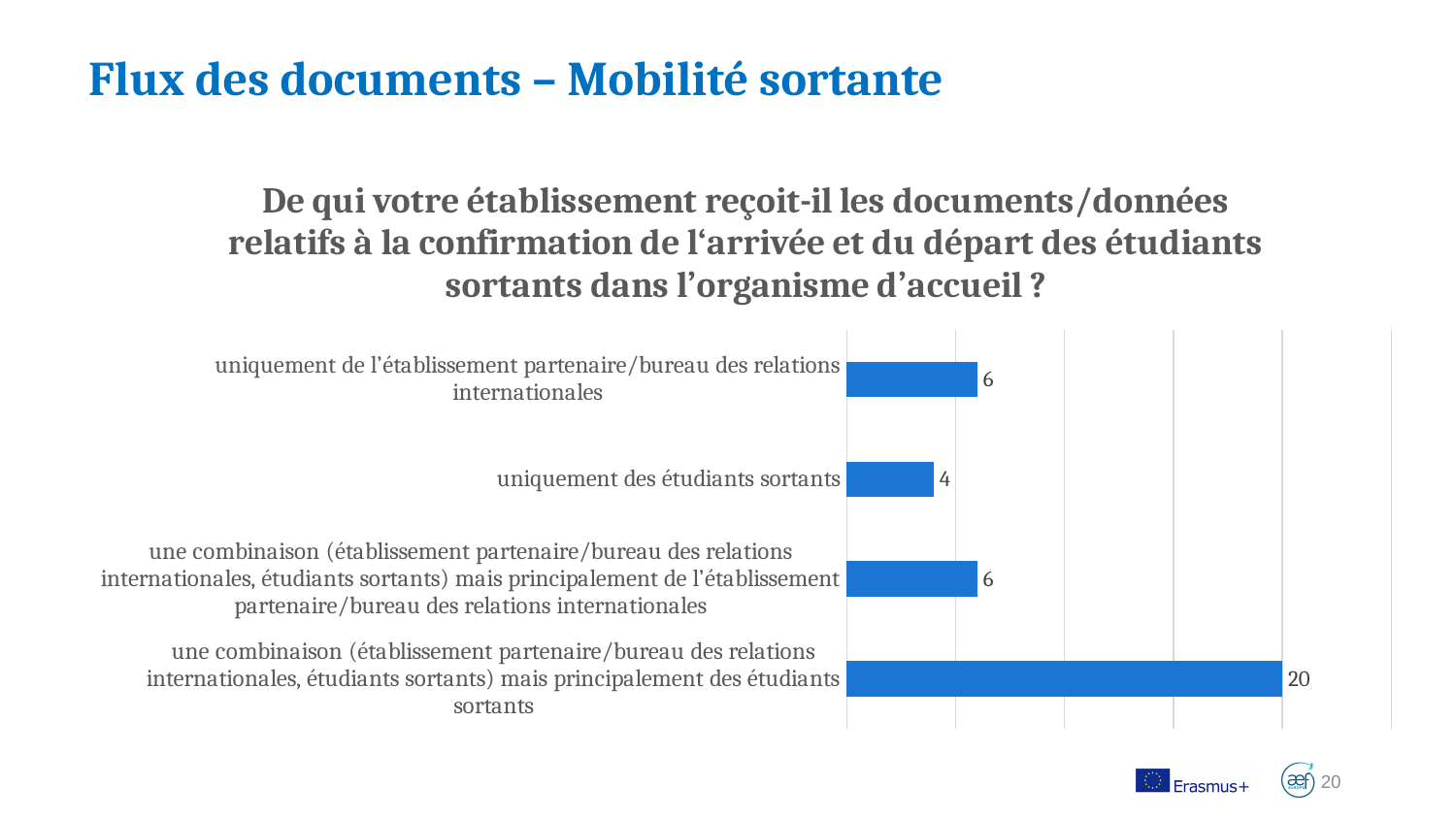
What type of chart is shown on the slide? bar chart What is the difference between the highest value (20) and the value for "uniquement des étudiants sortants"? 16 What is the value for the combination option that is mainly from outgoing students ("principalement des étudiants sortants")? 20 What is the value for "uniquement des étudiants sortants"? 4 Which category has the highest value? une combinaison (établissement partenaire/bureau des relations internationales, étudiants sortants) mais principalement des étudiants sortants What colour are the bars in the chart? blue Which category has the lowest value? uniquement des étudiants sortants What is the value for the combination option that is mainly from the partner institution/international relations office? 6 What is the difference between the value for "uniquement de l'établissement partenaire/bureau des relations internationales" and the value for "uniquement des étudiants sortants"? 2 Which is larger: the value for "uniquement des étudiants sortants" or the value for "uniquement de l'établissement partenaire/bureau des relations internationales"? uniquement de l'établissement partenaire/bureau des relations internationales What is the value for "uniquement de l'établissement partenaire/bureau des relations internationales"? 6 How many categories are shown in the chart? 4